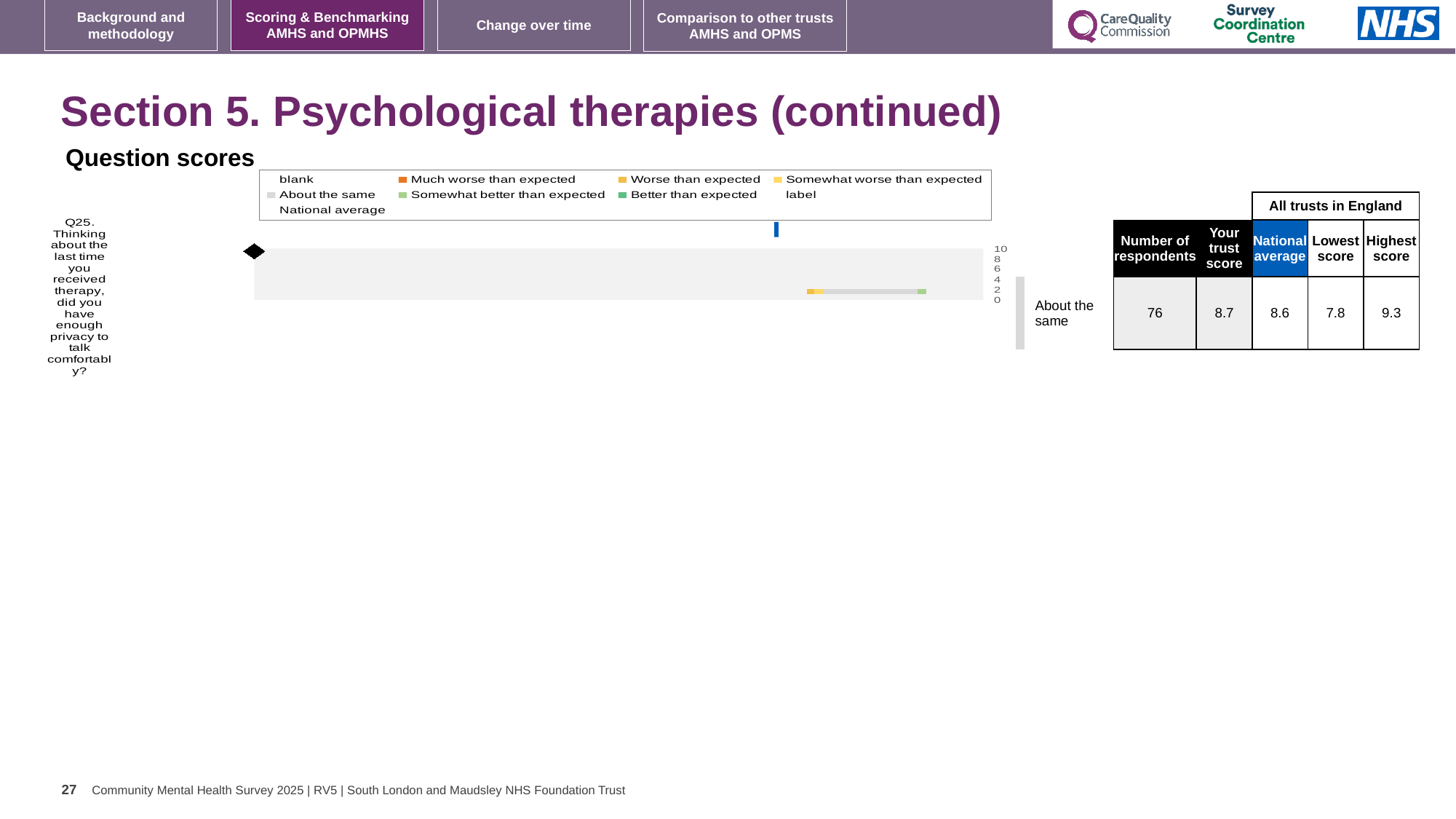
What is the national average score for Q25? 8.6 What is the highest score among all trusts in England for Q25? 9.3 By how much does the trust's score for Q25 exceed the national average? 0.1 Which is larger for Q25: the trust's score or the national average? the trust's score What is the trust's score for Q25 (privacy to talk comfortably during therapy)? 8.7 What is the lowest score among all trusts in England for Q25? 7.8 What kind of chart is used to show the Q25 question score? bar chart What is the difference between the highest and lowest scores for Q25 across all trusts in England? 1.5 How many survey questions are plotted on the chart? 1 What is the number of respondents for Q25? 76 Is the trust's score for Q25 greater or less than 8? greater What benchmark category is shown for Q25 next to the chart? About the same